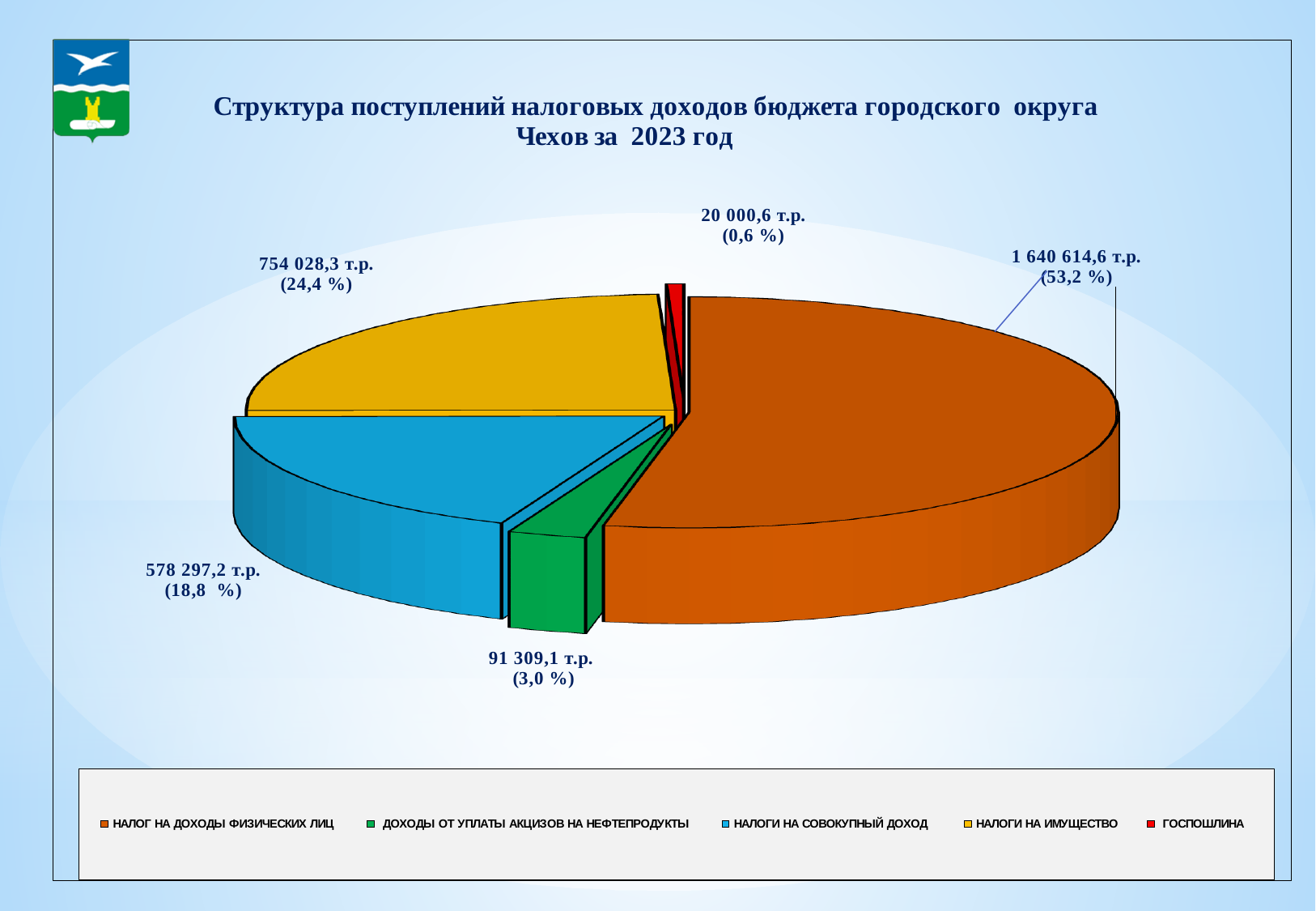
What share of the pie does НАЛОГ НА ДОХОДЫ ФИЗИЧЕСКИХ ЛИЦ represent? 53,2 % What is the value for ДОХОДЫ ОТ УПЛАТЫ АКЦИЗОВ НА НЕФТЕПРОДУКТЫ? 91 309,1 т.р. What kind of chart is shown on the slide? Pie chart Which is larger: НАЛОГИ НА ИМУЩЕСТВО or НАЛОГИ НА СОВОКУПНЫЙ ДОХОД? НАЛОГИ НА ИМУЩЕСТВО Which category has the largest slice of the pie? НАЛОГ НА ДОХОДЫ ФИЗИЧЕСКИХ ЛИЦ What is the value for НАЛОГИ НА СОВОКУПНЫЙ ДОХОД? 578 297,2 т.р. What is the value for НАЛОГИ НА ИМУЩЕСТВО? 754 028,3 т.р. What is the value for НАЛОГ НА ДОХОДЫ ФИЗИЧЕСКИХ ЛИЦ? 1 640 614,6 т.р. What colour is the slice for ДОХОДЫ ОТ УПЛАТЫ АКЦИЗОВ НА НЕФТЕПРОДУКТЫ? Green Which category has the smallest slice of the pie? ГОСПОШЛИНА What share of the pie does ГОСПОШЛИНА represent? 0,6 % How many categories does the legend of the pie chart list? 5